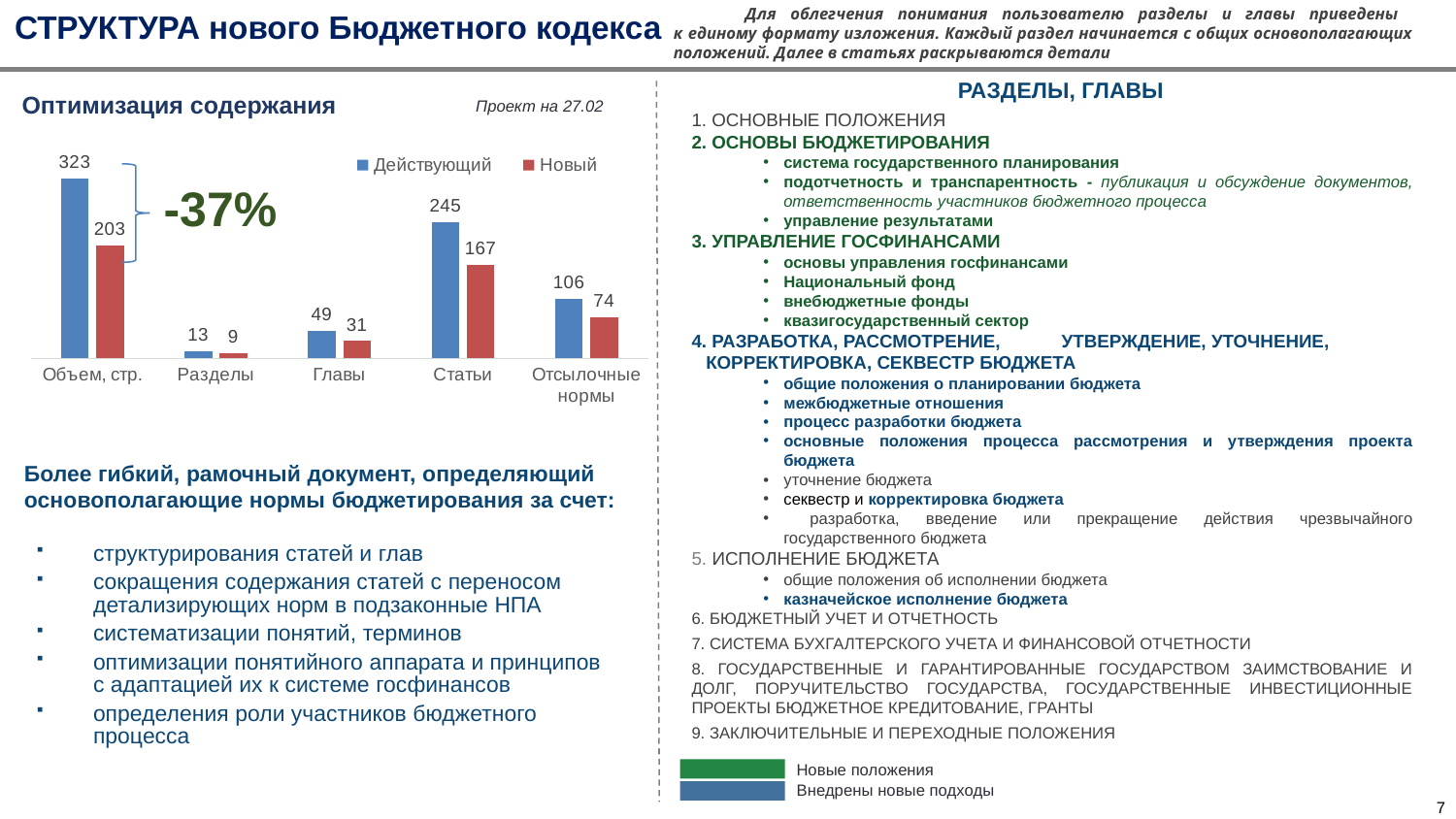
Which is larger for "Статьи": "Действующий" or "Новый"? Действующий Which category has the highest value for the "Действующий" series? Объем, стр. What is the difference between "Действующий" and "Новый" for "Главы"? 18 What is the value of "Новый" for "Статьи"? 167 What is the difference between "Действующий" and "Новый" for "Объем, стр."? 120 What is the value of "Действующий" for "Объем, стр."? 323 Which category has the lowest value for the "Новый" series? Разделы What percentage change is annotated next to the "Объем, стр." bars? -37% How many categories are shown on the x axis of the chart? 5 How many series does the chart legend list? 2 What is the value of "Новый" for "Отсылочные нормы"? 74 What type of chart is shown under "Оптимизация содержания"? bar chart